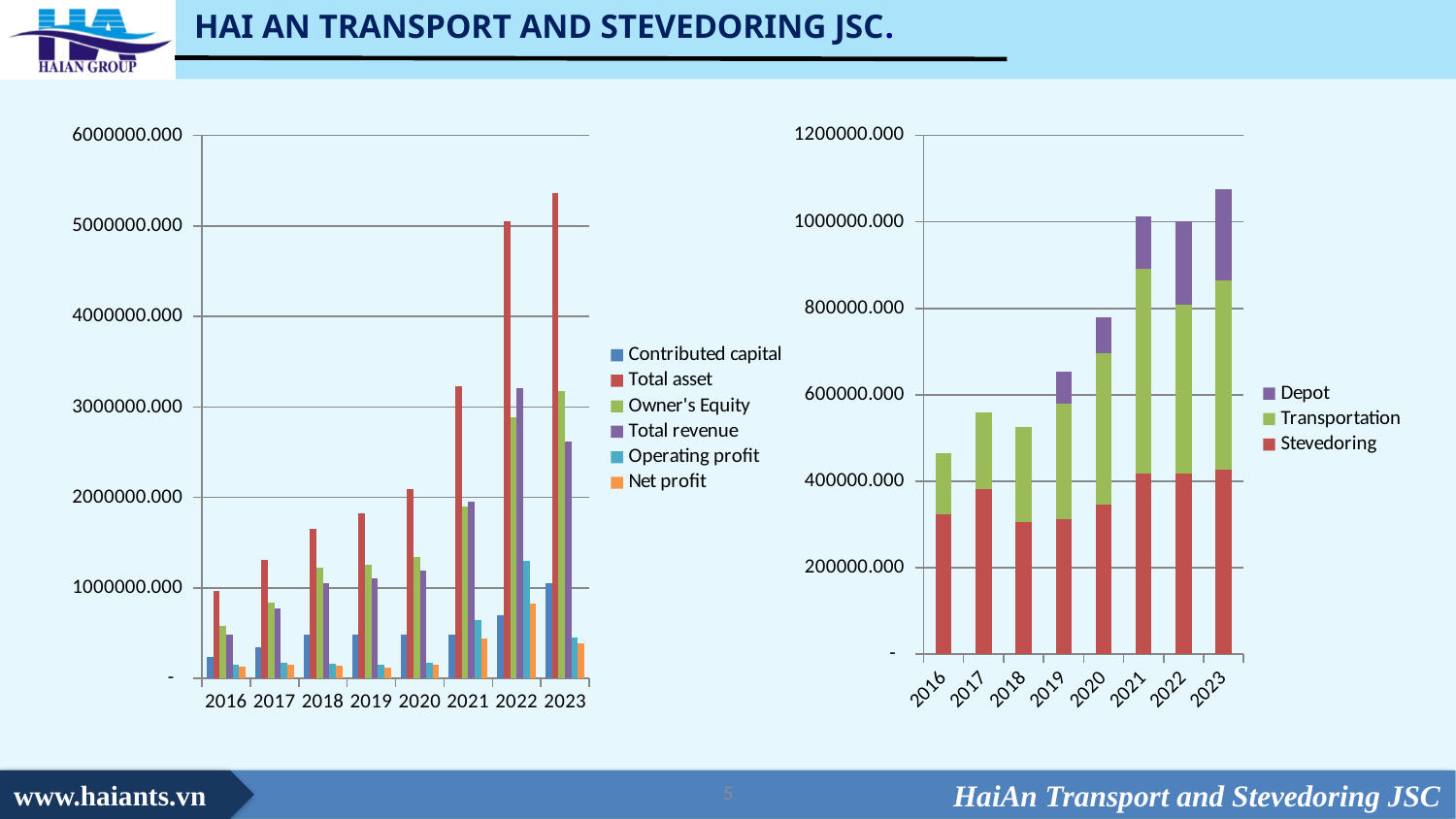
How many series does the legend of the left chart list? 6 In the left chart, is the Total asset for 2016 greater or less than 1000000.000? less What kind of chart is the chart on the right of the slide? stacked bar chart In the right chart, which year has the tallest stacked bar? 2023 In the left chart, is the Total asset for 2023 greater or less than 5000000.000? greater What kind of chart is the chart on the left of the slide? bar chart In the left chart, which year has the highest Total asset? 2023 In the right chart, which series is shown in purple? Depot How many series does the legend of the right chart list? 3 In the left chart, which is larger in 2021: Total asset or Owner's Equity? Total asset How many years are shown on the x axis of the right chart? 8 In the right chart, is the Stevedoring value for 2023 greater or less than 400000.000? greater